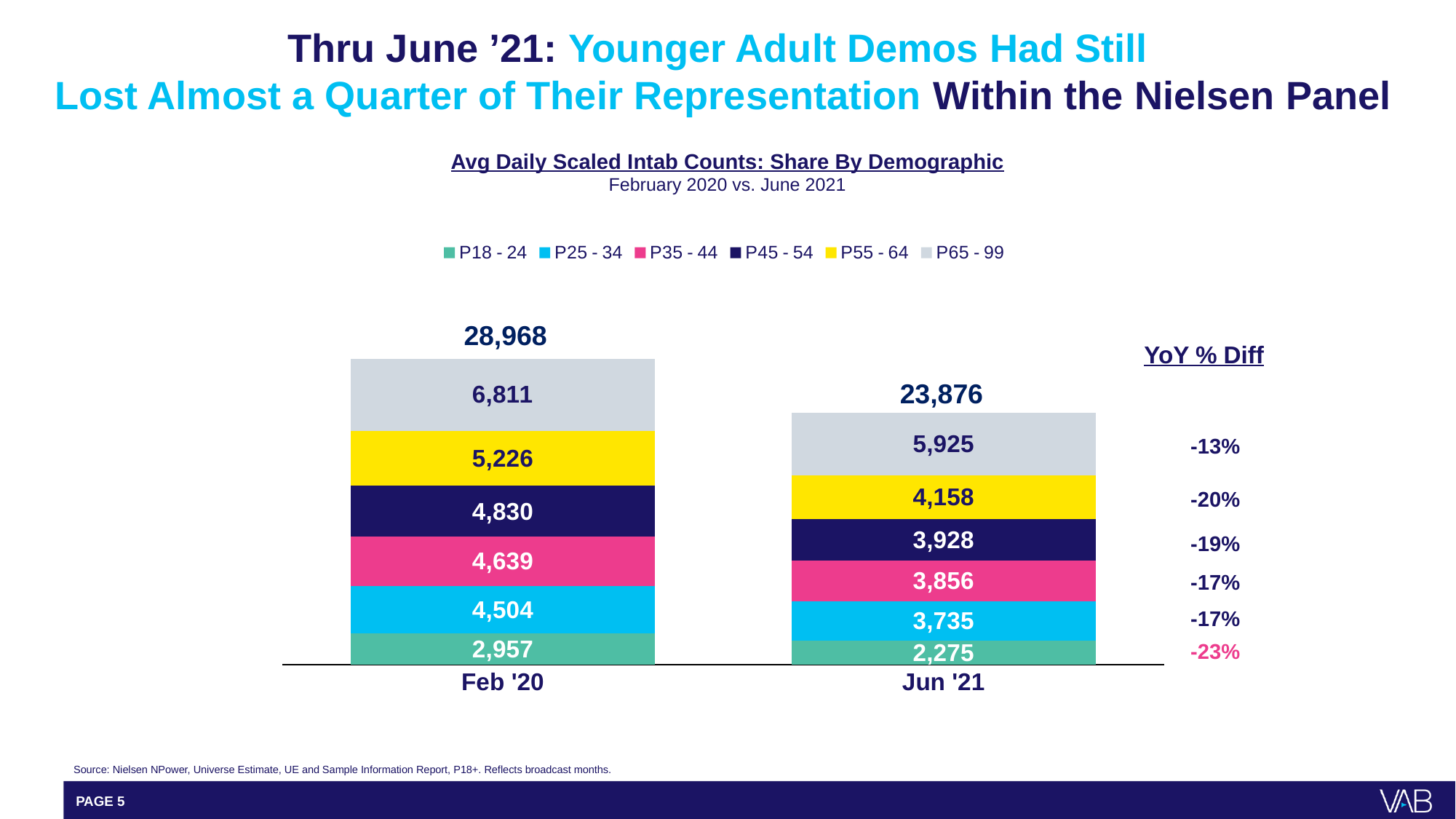
What is the value for P65 - 99 in the Jun '21 bar? 5,925 What kind of chart is shown on the slide? Stacked bar chart Which demographic segment is the smallest in the Jun '21 bar? P18 - 24 How many bars (time periods) are plotted on the chart? 2 What is the total of the Jun '21 stacked bar? 23,876 How many series does the legend list? 6 What is the value for P45 - 54 in the Jun '21 bar? 3,928 What is the difference between the P65 - 99 value in Feb '20 and in Jun '21? 886 Which is larger, the P55 - 64 value in Feb '20 or the P55 - 64 value in Jun '21? Feb '20 What is the total of the Feb '20 stacked bar? 28,968 What is the value for P18 - 24 in the Feb '20 bar? 2,957 Which demographic segment is the largest in the Feb '20 bar? P65 - 99